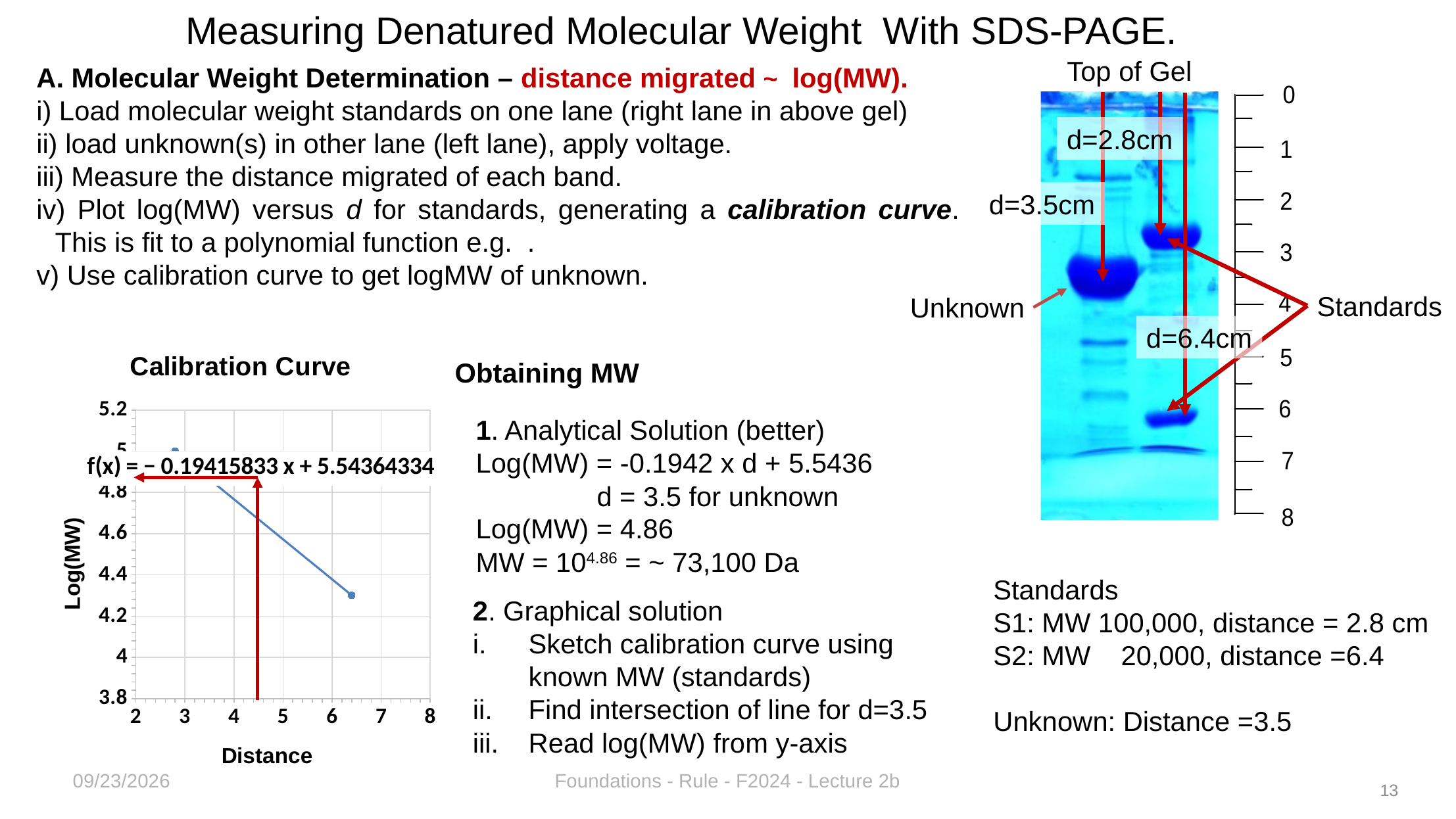
What is the title of the chart on the slide? Calibration Curve On the Calibration Curve chart, which point has the higher Log(MW): the leftmost point or the rightmost point? the leftmost point What type of chart is the Calibration Curve? scatter chart with a fitted line What is the lowest value shown on the y axis of the Calibration Curve chart? 3.8 What is the highest value shown on the x axis of the Calibration Curve chart? 8 How many data points are plotted on the Calibration Curve chart? 2 On the Calibration Curve chart, is the Log(MW) value of the rightmost point (near distance 6.4) greater or less than 4.4? less On the Calibration Curve chart, does Log(MW) rise or fall as Distance increases? fall What is the trendline equation printed on the Calibration Curve chart? f(x) = − 0.19415833 x + 5.54364334 On the Calibration Curve chart, is the Log(MW) value of the leftmost point (near distance 2.8) greater or less than 4.8? greater On the Calibration Curve chart, is the Log(MW) value of the rightmost point (near distance 6.4) greater or less than 4.2? greater